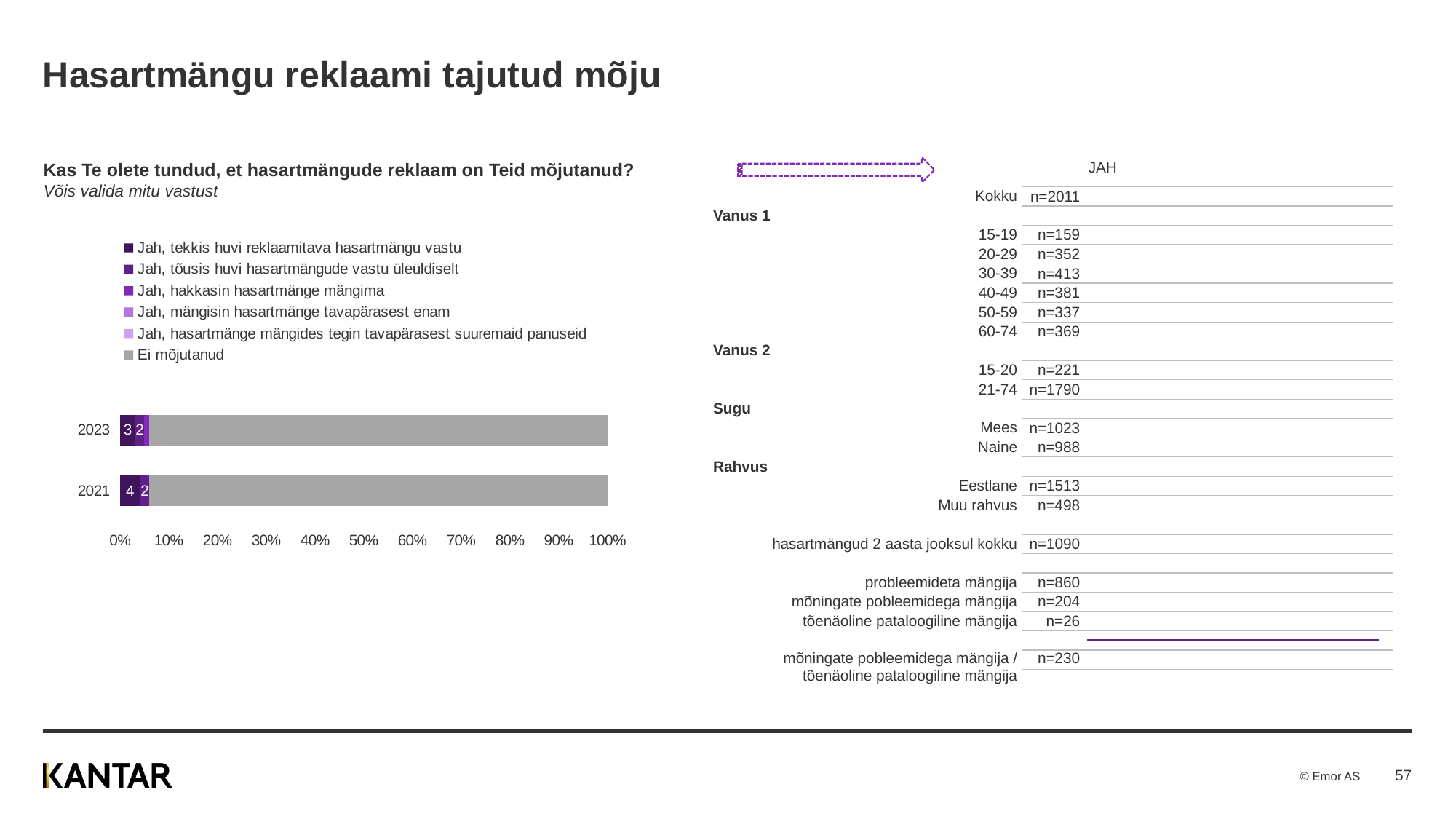
What colour represents "Ei mõjutanud" in the chart? grey What kind of chart is shown on the slide? bar chart What is the difference between the 2021 and 2023 values for "Jah, tekkis huvi reklaamitava hasartmängu vastu"? 1 What is the value for "Jah, tõusis huvi hasartmängude vastu üleüldiselt" in 2023? 2 Is the value for "Ei mõjutanud" in 2023 greater or less than 80%? greater What is the value for "Jah, tõusis huvi hasartmängude vastu üleüldiselt" in 2021? 2 Which year has the larger value for "Jah, tekkis huvi reklaamitava hasartmängu vastu", 2023 or 2021? 2021 How many series does the chart legend list? 6 What is the highest value shown on the chart's x axis? 100% How many years (categories) are plotted in the bar chart? 2 What is the value for "Jah, tekkis huvi reklaamitava hasartmängu vastu" in 2023? 3 What is the value for "Jah, tekkis huvi reklaamitava hasartmängu vastu" in 2021? 4